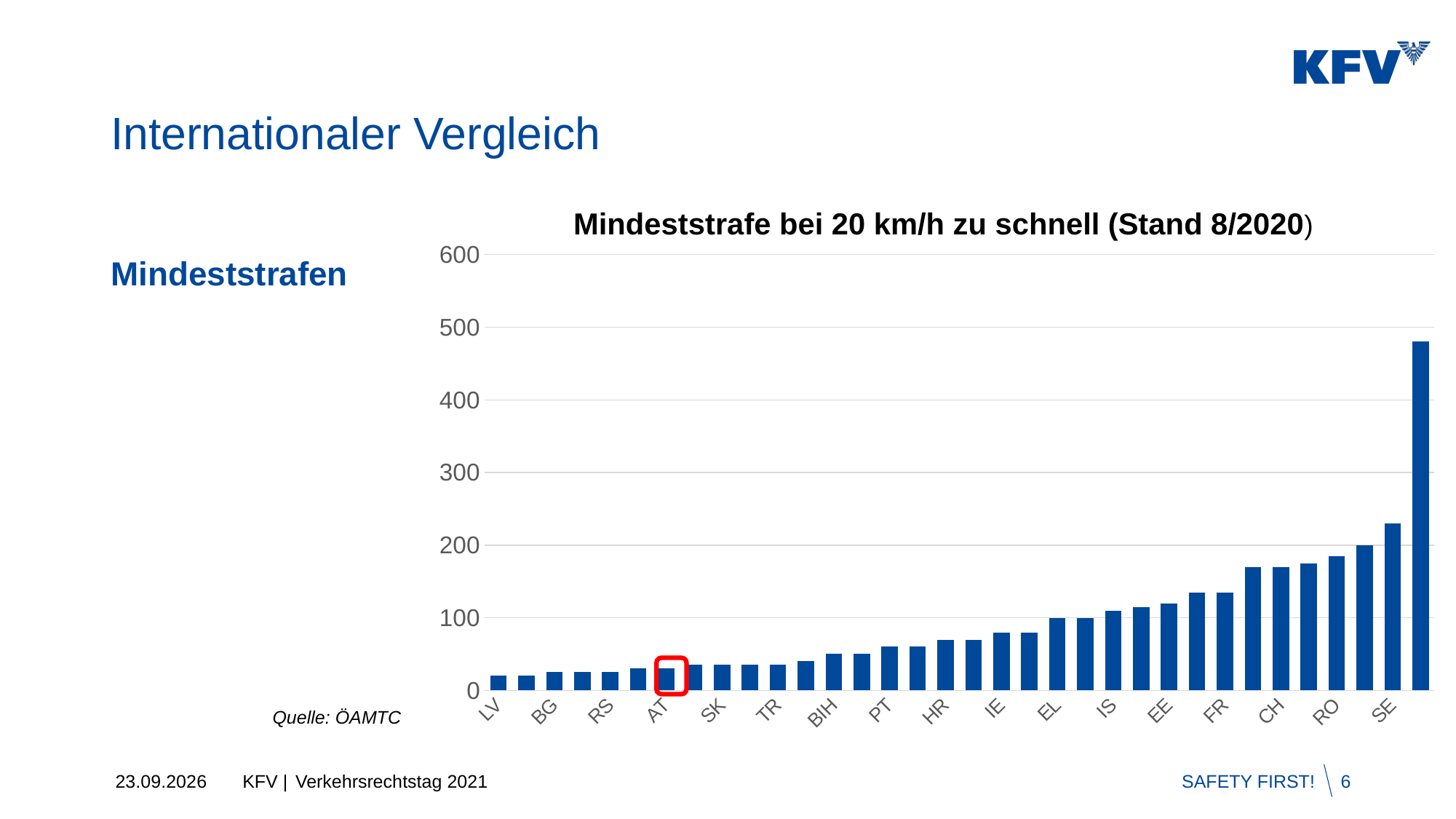
What kind of chart is shown on the slide? bar chart Is the value for RO greater or less than 300? less What is the title of the chart? Mindeststrafe bei 20 km/h zu schnell (Stand 8/2020) Is the value for CH greater or less than 100? greater Which category's bar is highlighted with a red box? AT Do the values rise or fall from left to right along the x axis? rise Is the value for SE greater or less than 100? greater Which has the larger value, SE or LV? SE Which has the larger value, CH or AT? CH